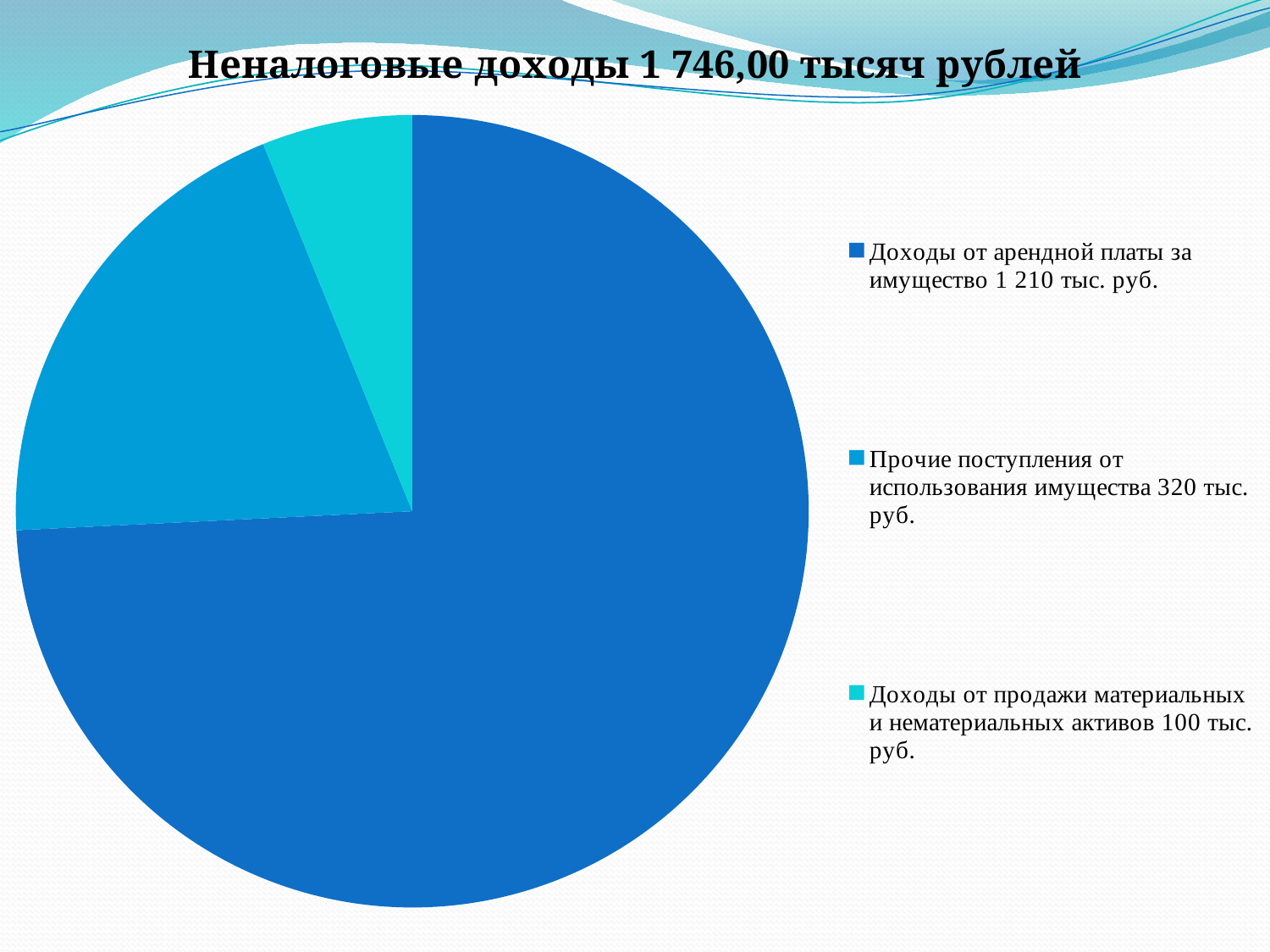
What is the difference between 'Прочие поступления от использования имущества' and 'Доходы от продажи материальных и нематериальных активов'? 220 тыс. руб. What is the difference between 'Доходы от арендной платы за имущество' and 'Прочие поступления от использования имущества'? 890 тыс. руб. How many entries does the legend list? 3 What is the title of the chart on the slide? Неналоговые доходы 1 746,00 тысяч рублей What kind of chart is shown on the slide? pie chart What is the value for 'Доходы от арендной платы за имущество' in the legend? 1 210 тыс. руб. Which is larger: 'Прочие поступления от использования имущества' or 'Доходы от продажи материальных и нематериальных активов'? Прочие поступления от использования имущества Which category has the smallest slice of the pie? Доходы от продажи материальных и нематериальных активов Which category has the largest slice of the pie? Доходы от арендной платы за имущество How many slices does the pie chart have? 3 What is the value for 'Прочие поступления от использования имущества' in the legend? 320 тыс. руб. What is the value for 'Доходы от продажи материальных и нематериальных активов' in the legend? 100 тыс. руб.